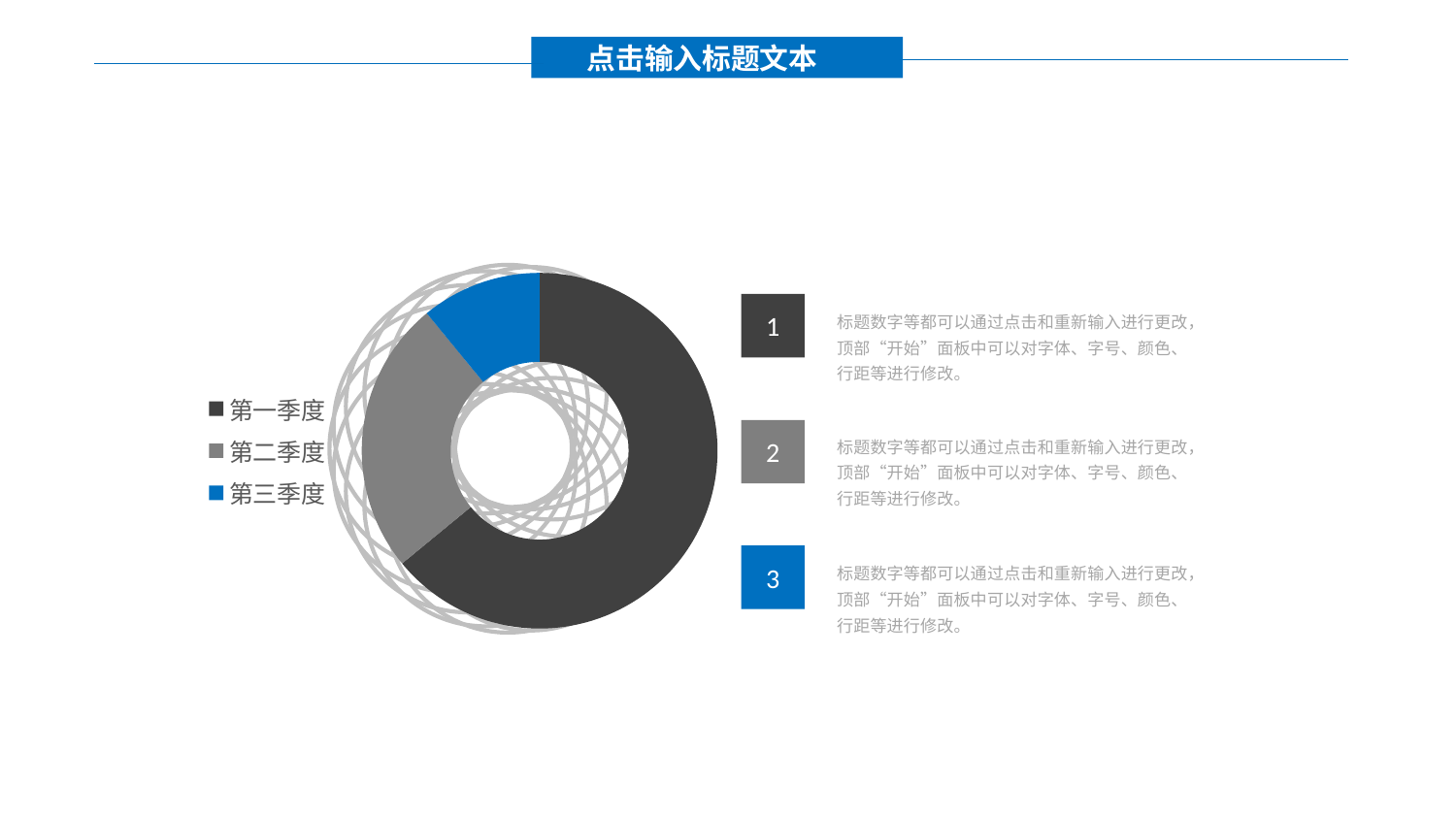
Which category has the largest slice in the chart? 第一季度 How many entries does the chart's legend list? 3 What colour is the 第三季度 slice in the chart? blue What kind of chart is shown on the slide? doughnut chart Which category has the smallest slice in the chart? 第三季度 What are the legend entries of the chart, in order? 第一季度, 第二季度, 第三季度 How many categories does the chart show? 3 Which slice is larger, 第二季度 or 第三季度? 第二季度 Does the 第一季度 slice take up more or less than half of the chart? more Which slice is larger, 第一季度 or 第二季度? 第一季度